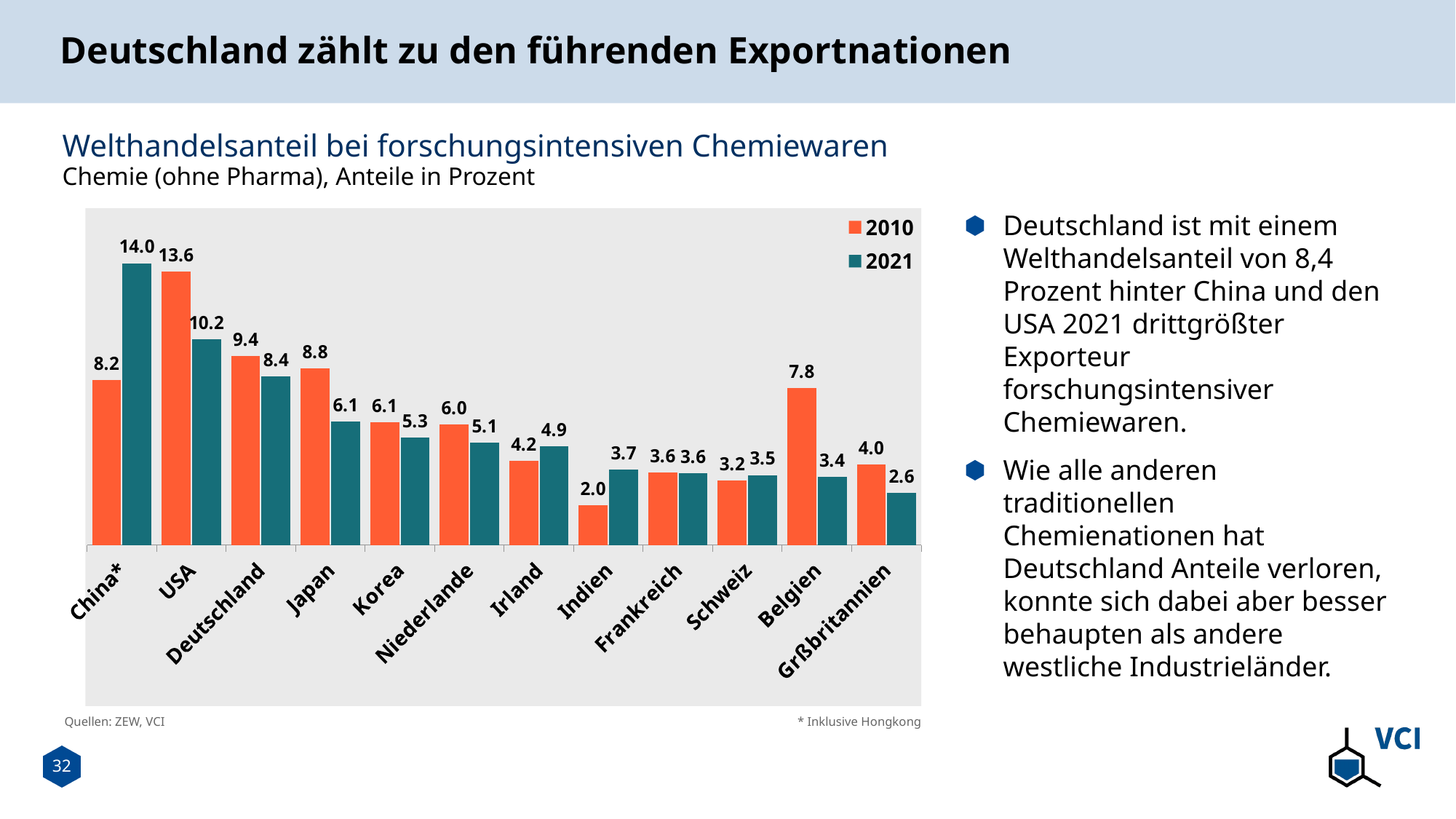
How many series does the legend list? 2 Which series is shown in orange in the legend? 2010 Which country has the lowest value in the 2010 series? Indien Which is larger for Japan: the 2010 value or the 2021 value? 2010 What is the difference between the 2010 and 2021 values for Belgien? 4.4 What is the difference between the 2010 and 2021 values for USA? 3.4 What is the value for Indien in 2021? 3.7 What is the value for Deutschland in 2021? 8.4 How many countries are shown on the x axis of the chart? 12 What is the value for Belgien in 2010? 7.8 What kind of chart is shown on the slide? Bar chart Which country has the highest value in the 2021 series? China*